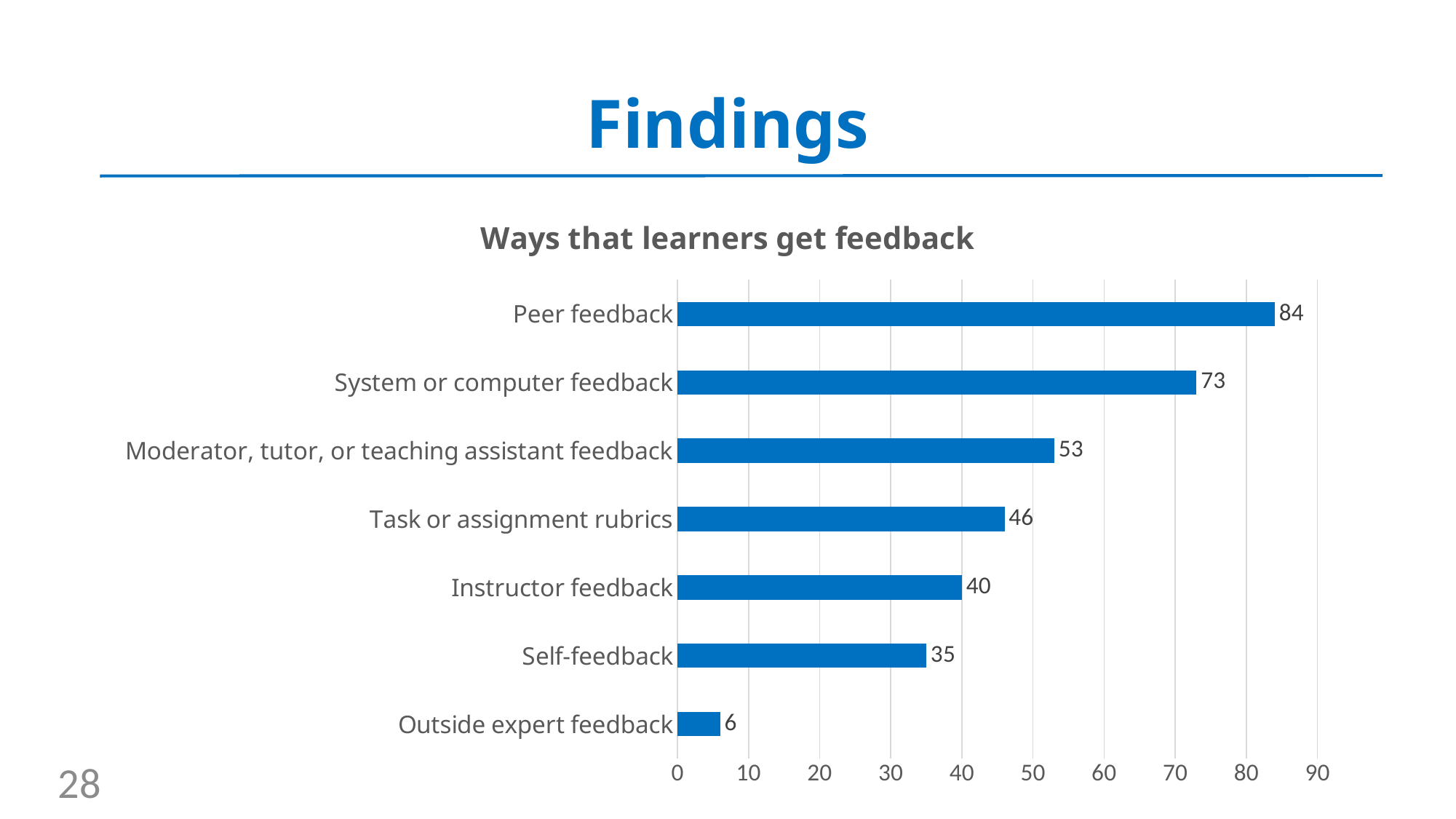
What is the title of the chart? Ways that learners get feedback Which is larger, Moderator, tutor, or teaching assistant feedback or Task or assignment rubrics? Moderator, tutor, or teaching assistant feedback What is the value for System or computer feedback? 73 How many categories are shown in the chart? 7 What is the difference between Instructor feedback and Self-feedback? 5 What is the value for Peer feedback? 84 What is the difference between Peer feedback and System or computer feedback? 11 Which category has the highest value? Peer feedback Which category has the lowest value? Outside expert feedback What is the value for Task or assignment rubrics? 46 What kind of chart is shown on the slide? Bar chart What is the value for Outside expert feedback? 6